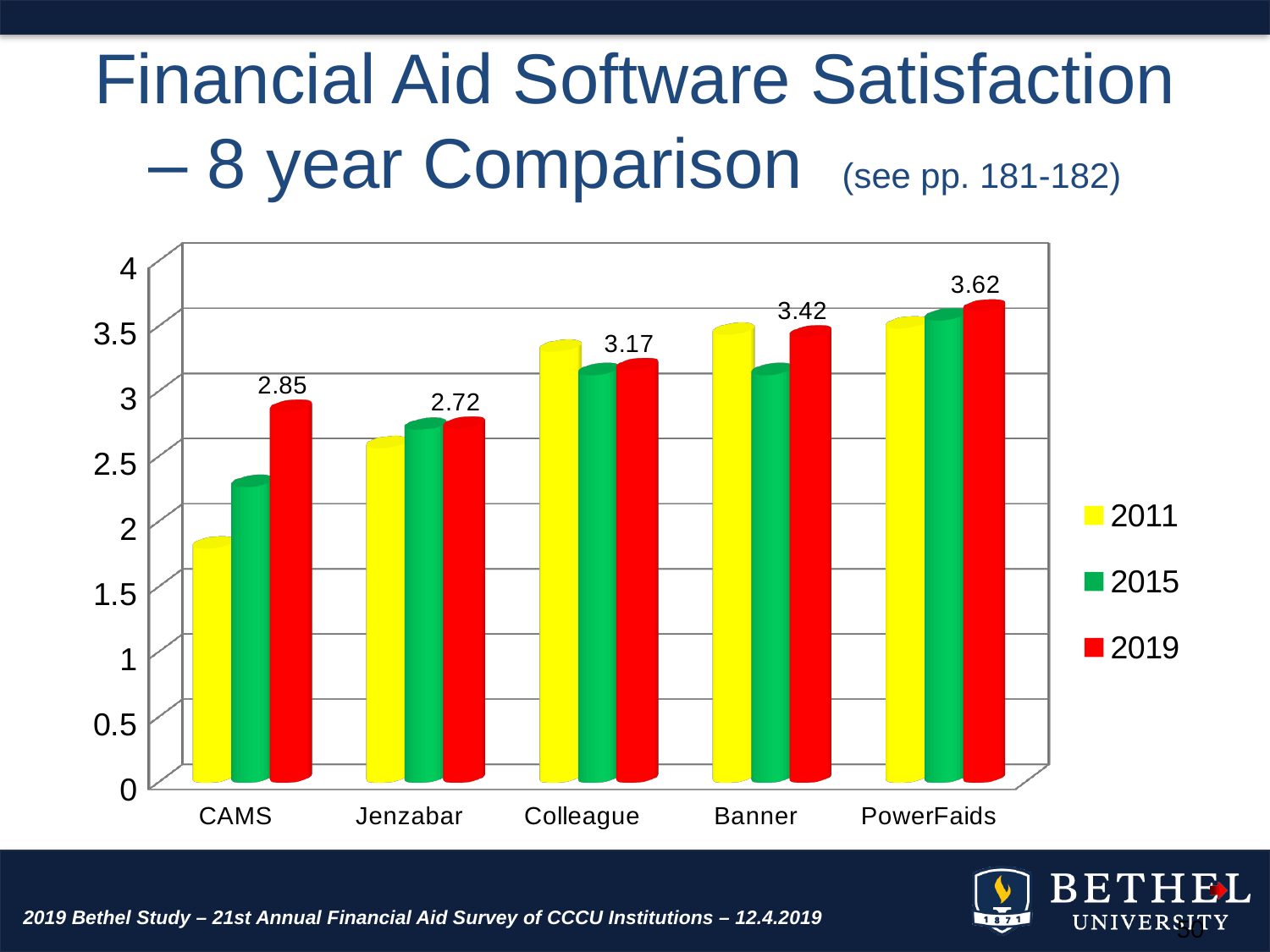
Which is larger, the 2019 value for Colleague or the 2019 value for Banner? Banner How many software products are shown on the x axis? 5 What is the difference between the 2019 values for PowerFaids and CAMS? 0.77 Which software has the lowest 2019 satisfaction value? Jenzabar What is the 2019 satisfaction value for PowerFaids? 3.62 What is the 2019 satisfaction value for Banner? 3.42 Which software has the highest 2019 satisfaction value? PowerFaids How many series does the legend list? 3 What is the 2019 satisfaction value for CAMS? 2.85 What kind of chart is shown on the slide? bar chart Is the 2011 value for CAMS greater or less than 2? less Is the 2011 value for Colleague greater or less than 3? greater